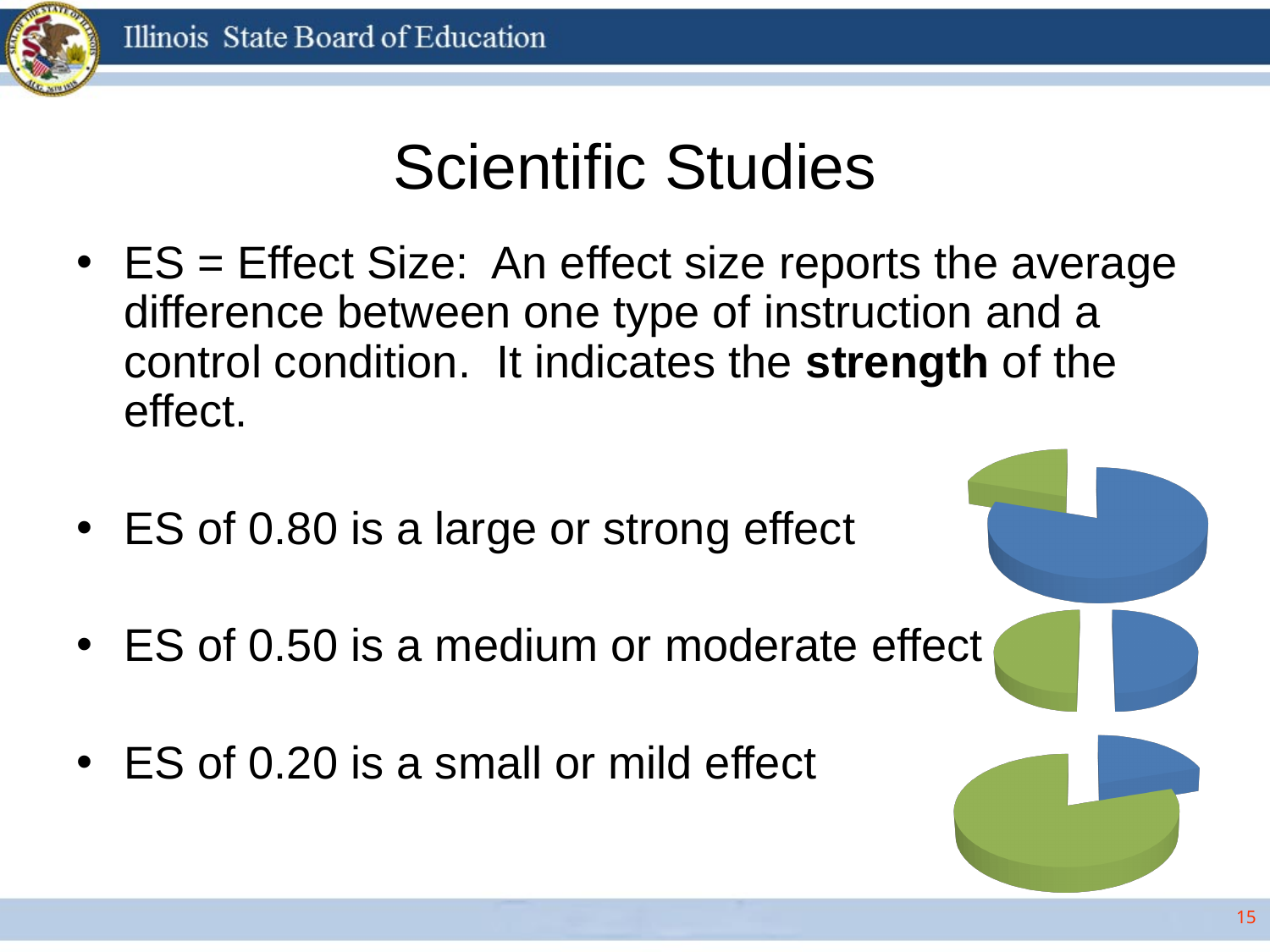
Which two colours are used for the slices in the pie charts? blue and green Do the pie charts on the slide show a legend or data labels? no How many slices does the top pie chart have? 2 In the bottom pie chart, is the blue slice more or less than half of the pie? less How many pie charts are on the slide? 3 In the top pie chart, which slice is larger, the blue one or the green one? blue In the bottom pie chart, which slice is larger, the blue one or the green one? green How many slices does the bottom pie chart have? 2 What kind of charts are shown on the right side of the slide? pie charts